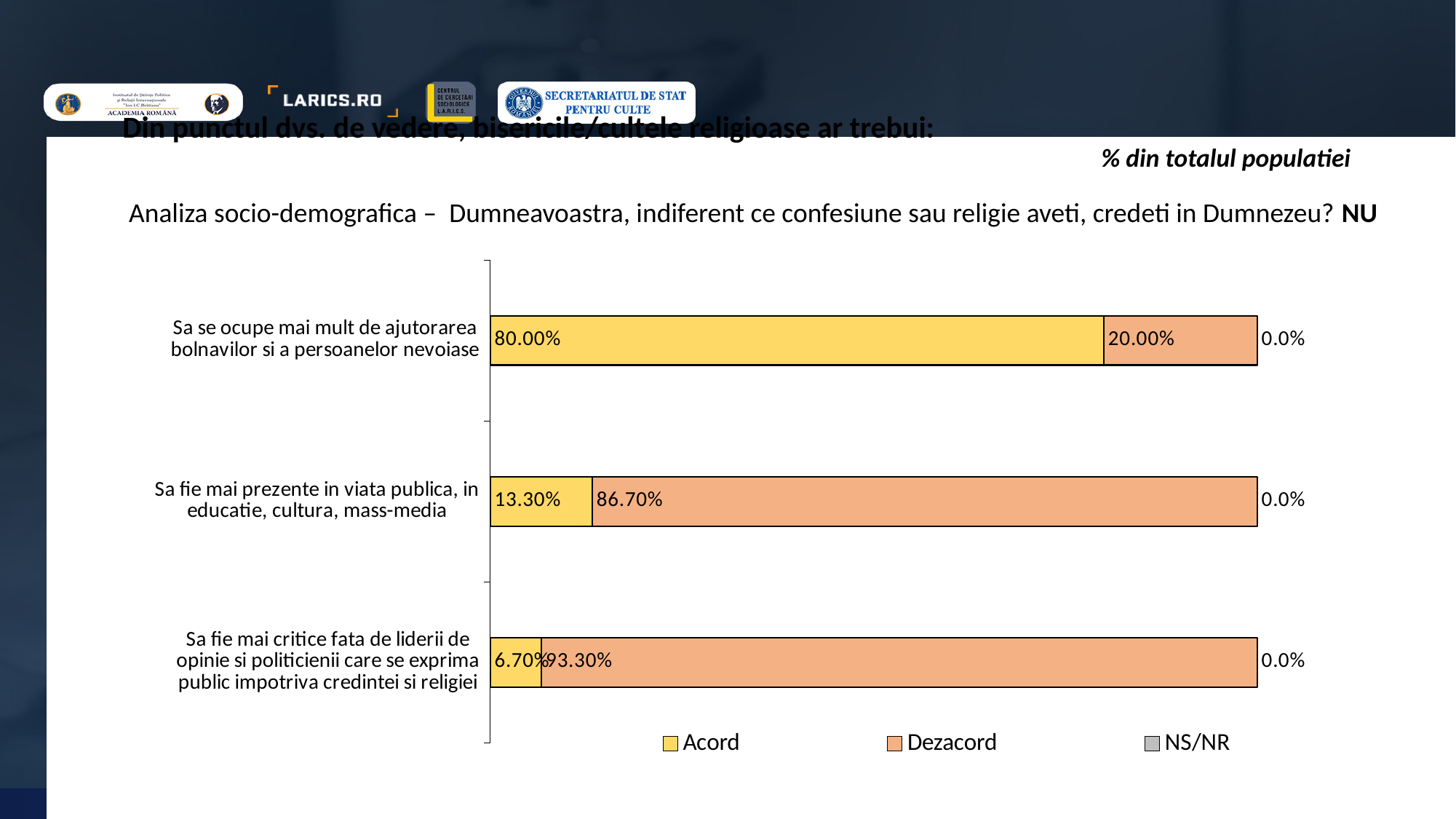
How many series does the legend list? 3 What is the Acord value for "Sa fie mai critice fata de liderii de opinie si politicienii care se exprima public impotriva credintei si religiei"? 6.70% Which category has the lowest Dezacord value? Sa se ocupe mai mult de ajutorarea bolnavilor si a persoanelor nevoiase Which series is shown in orange in the legend? Dezacord What is the difference between the Dezacord values for "Sa fie mai critice fata de liderii de opinie..." and "Sa fie mai prezente in viata publica..."? 6.60% What is the Dezacord value for "Sa fie mai prezente in viata publica, in educatie, cultura, mass-media"? 86.70% What is the NS/NR value for "Sa fie mai prezente in viata publica, in educatie, cultura, mass-media"? 0.0% How many categories are shown on the chart? 3 Which is larger: the Acord value for "Sa fie mai prezente in viata publica..." or the Acord value for "Sa fie mai critice fata de liderii de opinie..."? Sa fie mai prezente in viata publica, in educatie, cultura, mass-media What is the Acord value for "Sa se ocupe mai mult de ajutorarea bolnavilor si a persoanelor nevoiase"? 80.00% Which category has the highest Acord value? Sa se ocupe mai mult de ajutorarea bolnavilor si a persoanelor nevoiase What kind of chart is shown on the slide? Stacked bar chart